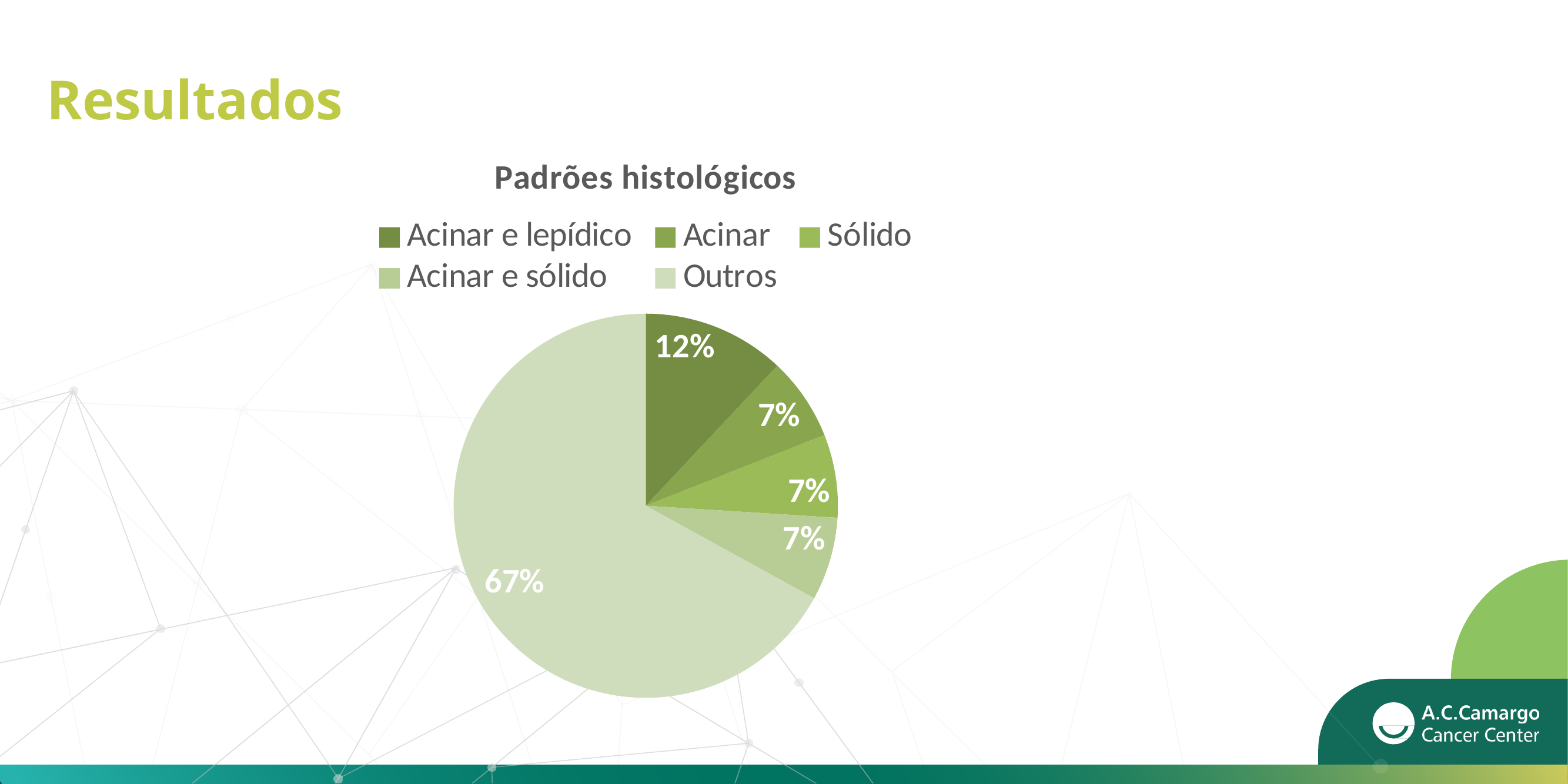
What share of the pie is Acinar e sólido? 7% Which category has the largest slice? Outros What share of the pie is Acinar e lepídico? 12% How many entries does the legend list? 5 What share of the pie is Sólido? 7% Which is larger, the share for Acinar e lepídico or the share for Sólido? Acinar e lepídico What kind of chart is shown on the slide? pie chart How many slices does the pie chart have? 5 What is the difference between the Outros share and the Acinar e lepídico share? 55% What is the title of the chart? Padrões histológicos